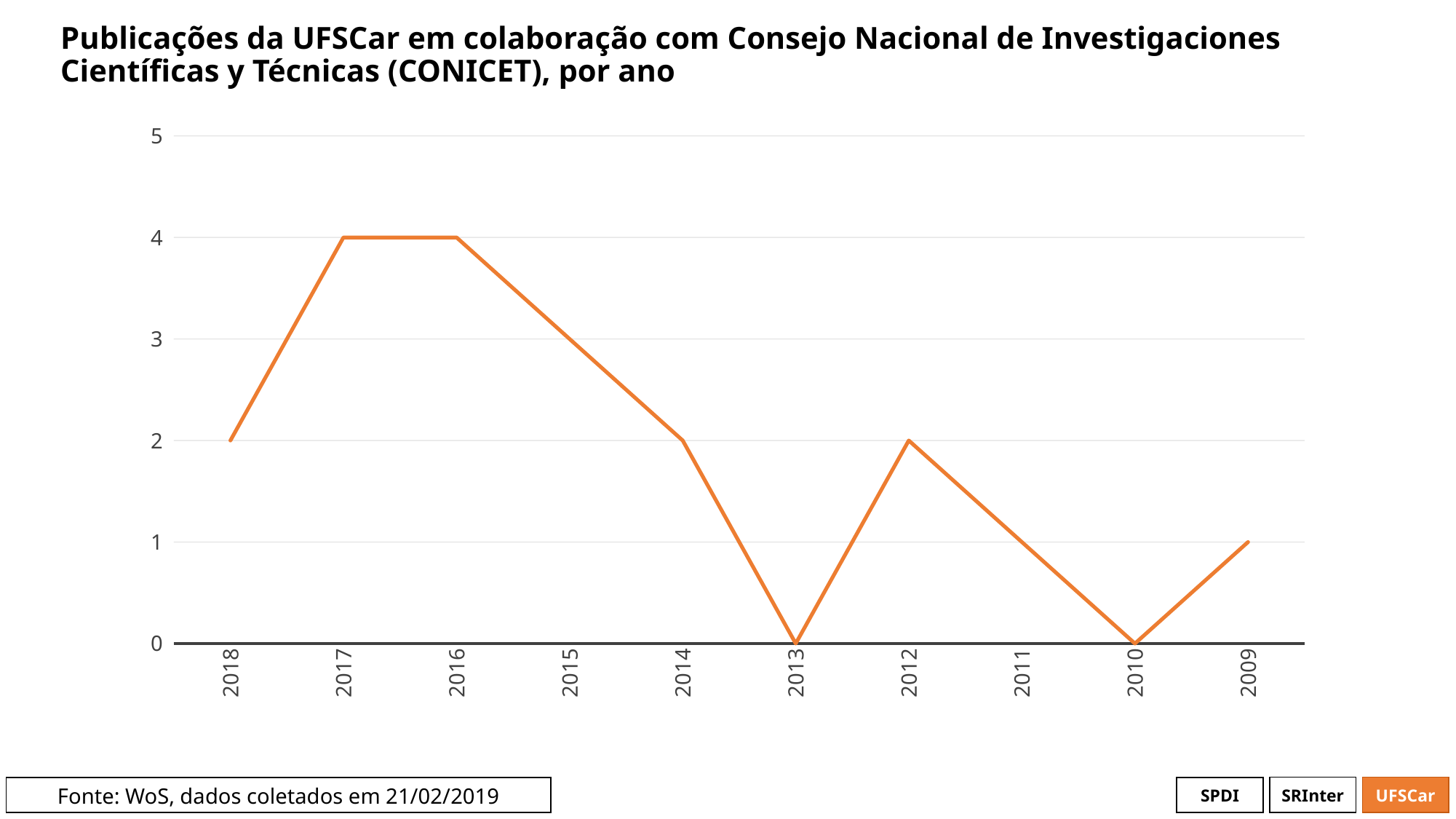
What is the value for 2018? 2 What is the value for 2017? 4 What is the value for 2009? 1 What is the difference between the values for 2016 and 2014? 2 Which is larger, the value for 2012 or the value for 2009? 2012 Which years have the highest value? 2017 and 2016 What is the value for 2013? 0 How many years are plotted on the x axis? 10 Is the value for 2017 greater or less than 3? greater Which years have the lowest value? 2013 and 2010 What kind of chart is shown on the slide? line chart What is the data source stated at the bottom of the slide? WoS, dados coletados em 21/02/2019